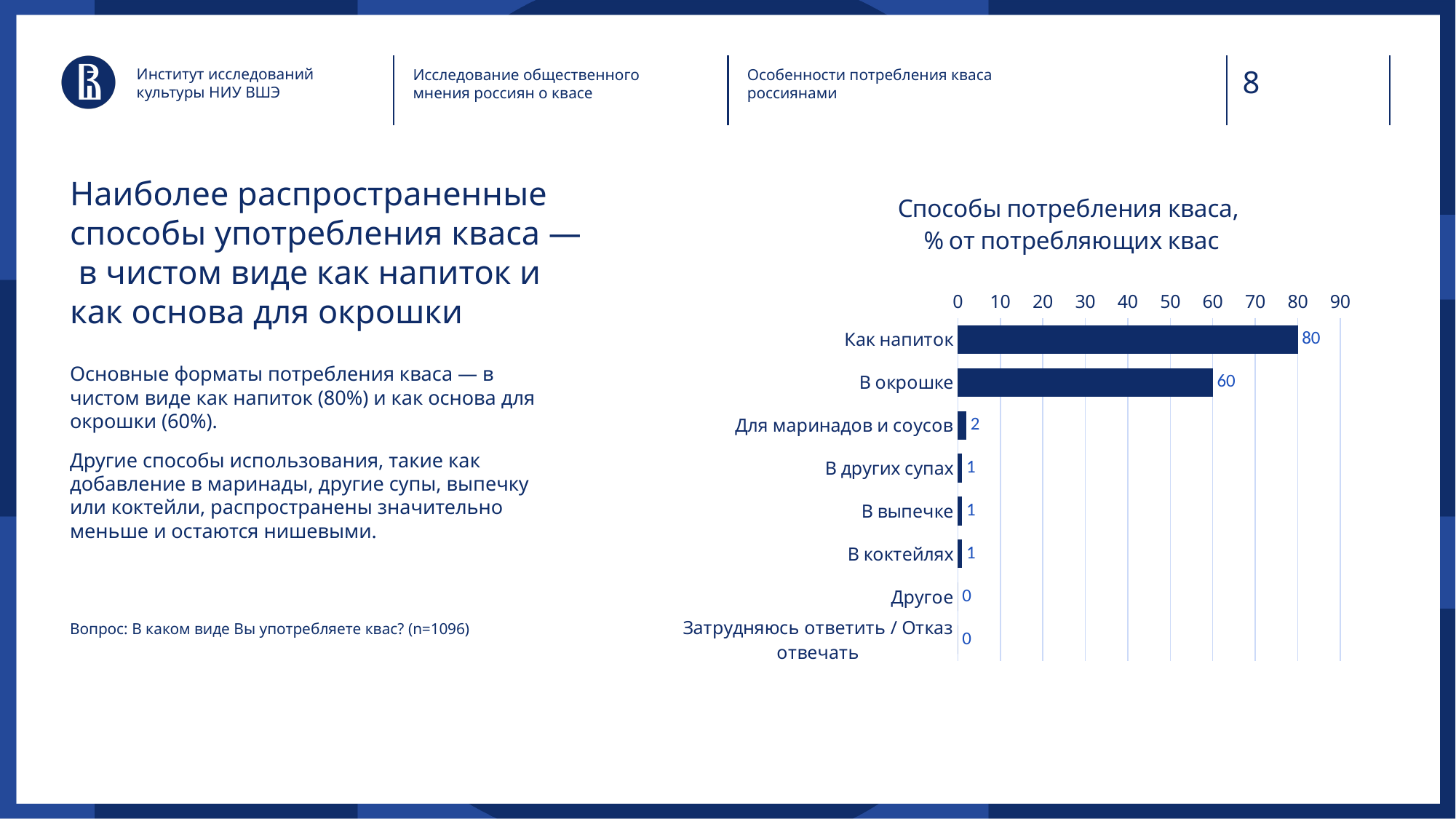
What is the value for "В коктейлях"? 1 Is the value for "Как напиток" greater or less than 70? greater What is the difference between the values for "Как напиток" and "В окрошке"? 20 What kind of chart is shown on the slide? bar chart What is the value for "Как напиток"? 80 What is the value for "Другое"? 0 What is the value for "В окрошке"? 60 What is the value for "Для маринадов и соусов"? 2 How many categories are shown on the chart? 8 What is the title of the chart? Способы потребления кваса, % от потребляющих квас Which is larger, the value for "В окрошке" or the value for "Для маринадов и соусов"? В окрошке Which category has the highest value? Как напиток